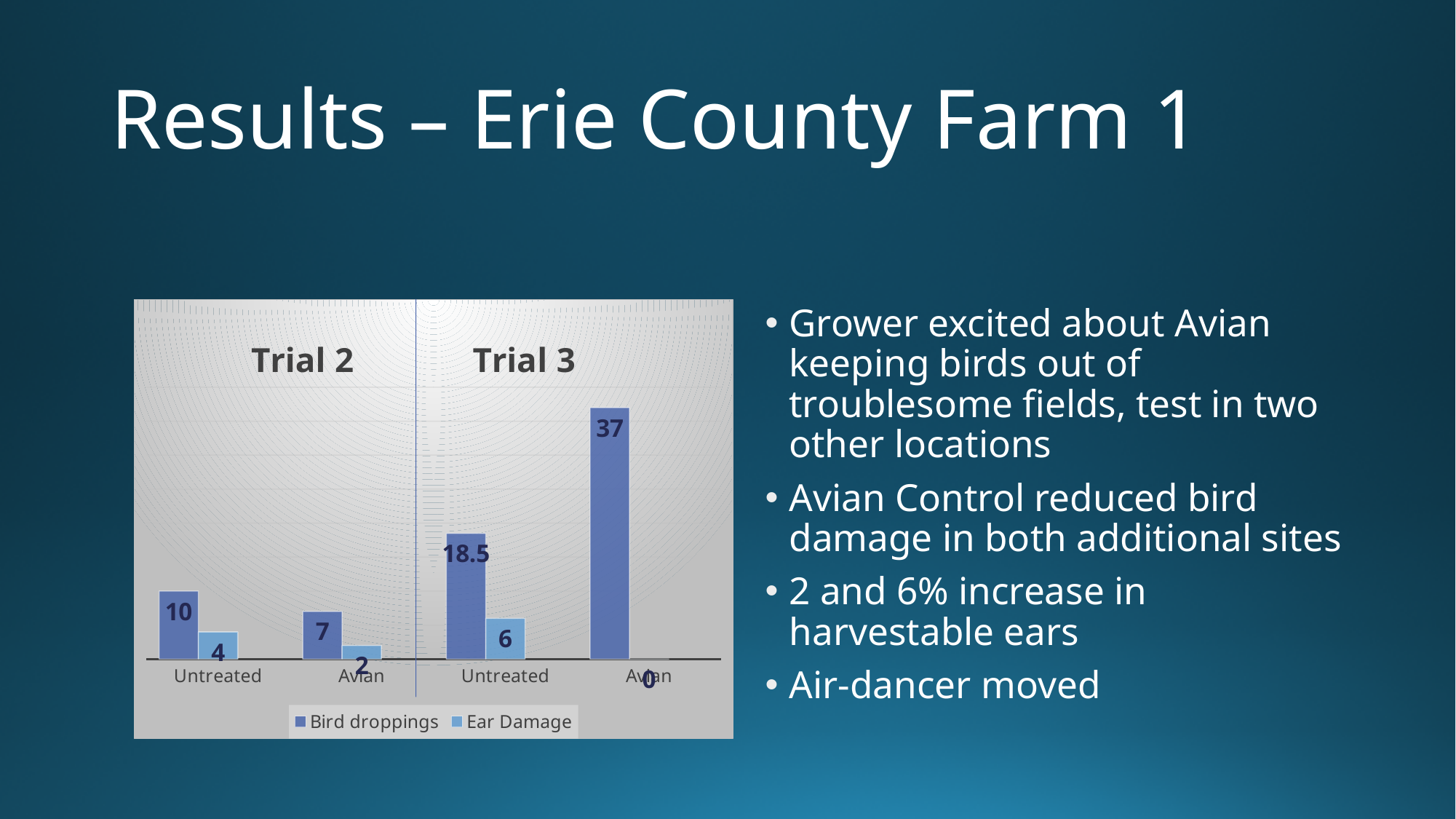
What are the two trial labels shown above the chart? Trial 2 and Trial 3 What is the Bird droppings value for Untreated in Trial 3? 18.5 Which category has the highest Bird droppings value? Avian (Trial 3) Which category has the lowest Ear Damage value? Avian (Trial 3) What is the Bird droppings value for Untreated in Trial 2? 10 Which is larger: the Ear Damage value for Untreated in Trial 3 or for Untreated in Trial 2? Untreated in Trial 3 What kind of chart is shown on the slide? Bar chart What is the Ear Damage value for Avian in Trial 2? 2 What is the Ear Damage value for Avian in Trial 3? 0 How many series does the legend list? 2 What is the difference between the Bird droppings values for Untreated and Avian in Trial 2? 3 How many categories are shown on the x axis? 4